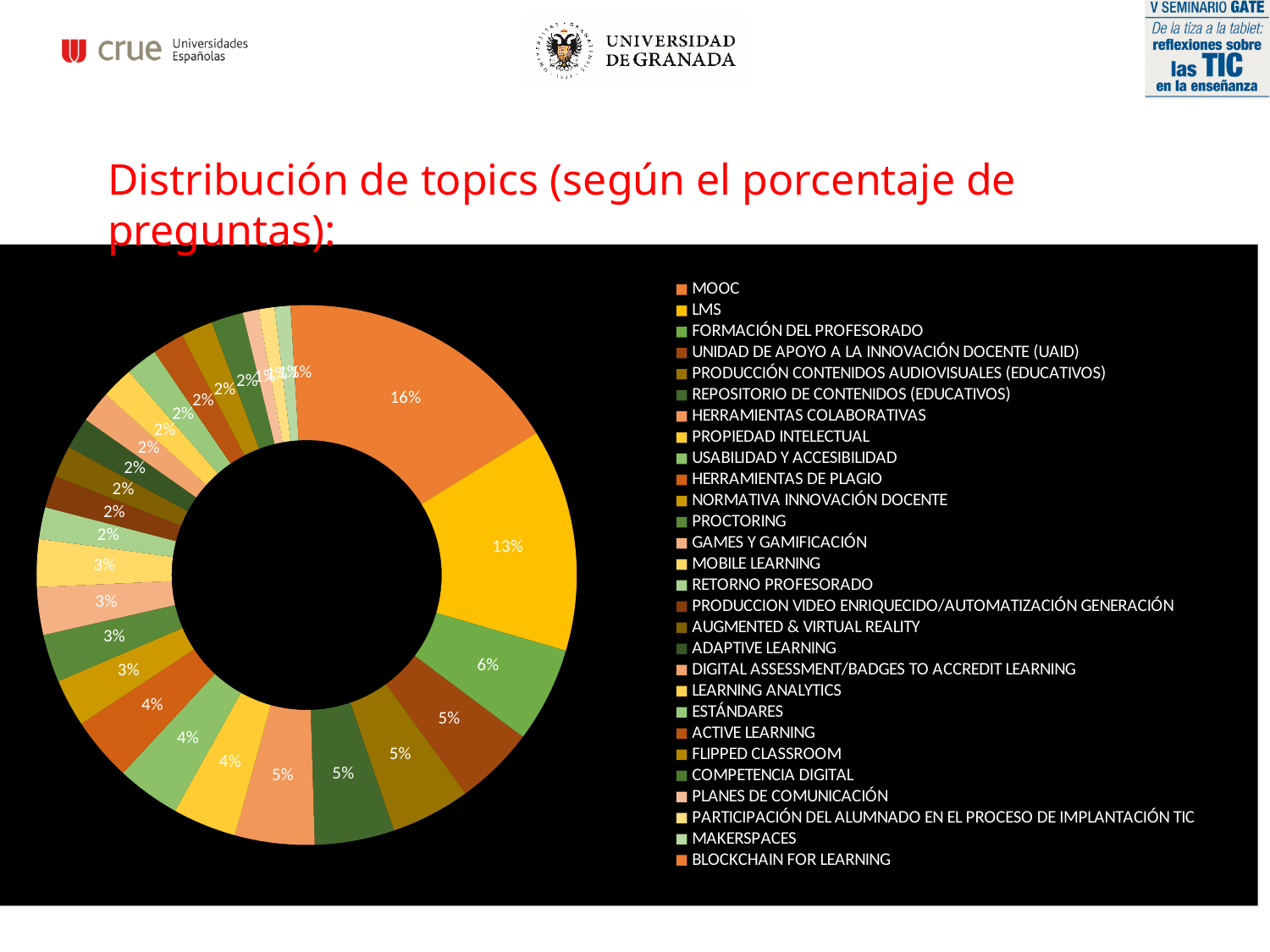
What kind of chart is shown on the slide? Doughnut (pie) chart What percentage of questions corresponds to MOOC? 16% How many topics does the legend list? 28 Which has a larger share, LMS or FORMACIÓN DEL PROFESORADO? LMS What is the difference in percentage points between the MOOC slice and the LMS slice? 3 percentage points What is the title of the chart on the slide? Distribución de topics (según el porcentaje de preguntas): What is the smallest percentage label shown on the chart? 1% Which has a larger share, MOOC or LMS? MOOC What percentage of questions corresponds to FORMACIÓN DEL PROFESORADO? 6% What percentage of questions corresponds to LMS? 13% What is the largest percentage label shown on the chart? 16% Which topic has the largest share of questions in the chart? MOOC